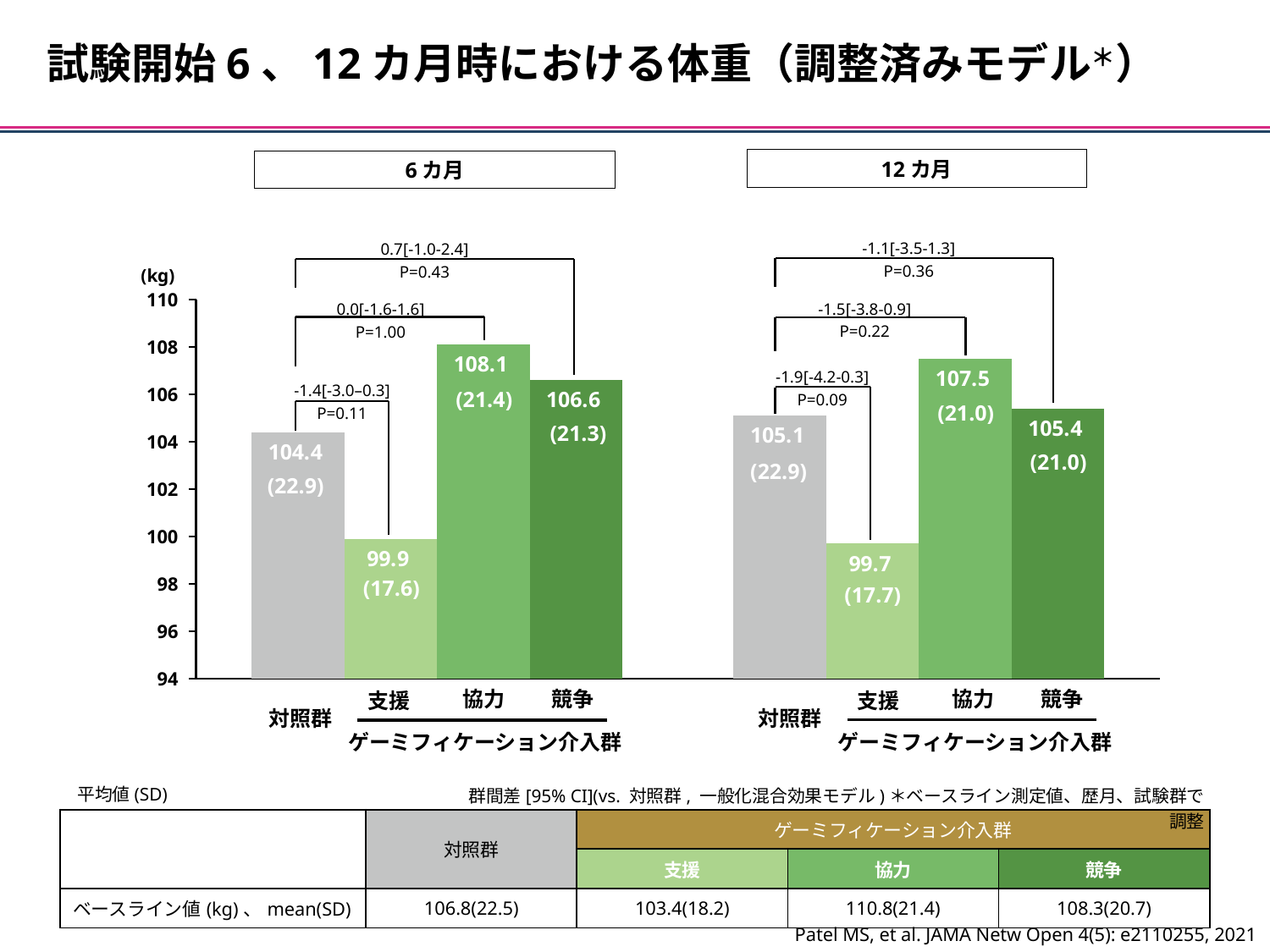
How many bars are shown in the 12カ月 chart? 4 In the 12カ月 chart, is the value for 支援 greater or less than 100? less In the 6カ月 chart, which is larger, the value for 競争 or the value for 対照群? 競争 In the 12カ月 chart, what is the difference between the values for 対照群 and 支援? 5.4 In the 6カ月 chart, what is the difference between the values for 協力 and 支援? 8.2 In the 6カ月 chart, what is the value for 対照群? 104.4 What kind of chart is the 6カ月 chart? bar chart In the 12カ月 chart, what is the value for 協力? 107.5 In the 6カ月 chart, which category has the highest value? 協力 In the 12カ月 chart, what is the value for 競争? 105.4 In the 12カ月 chart, which category has the lowest value? 支援 In the 6カ月 chart, what is the value for 支援? 99.9